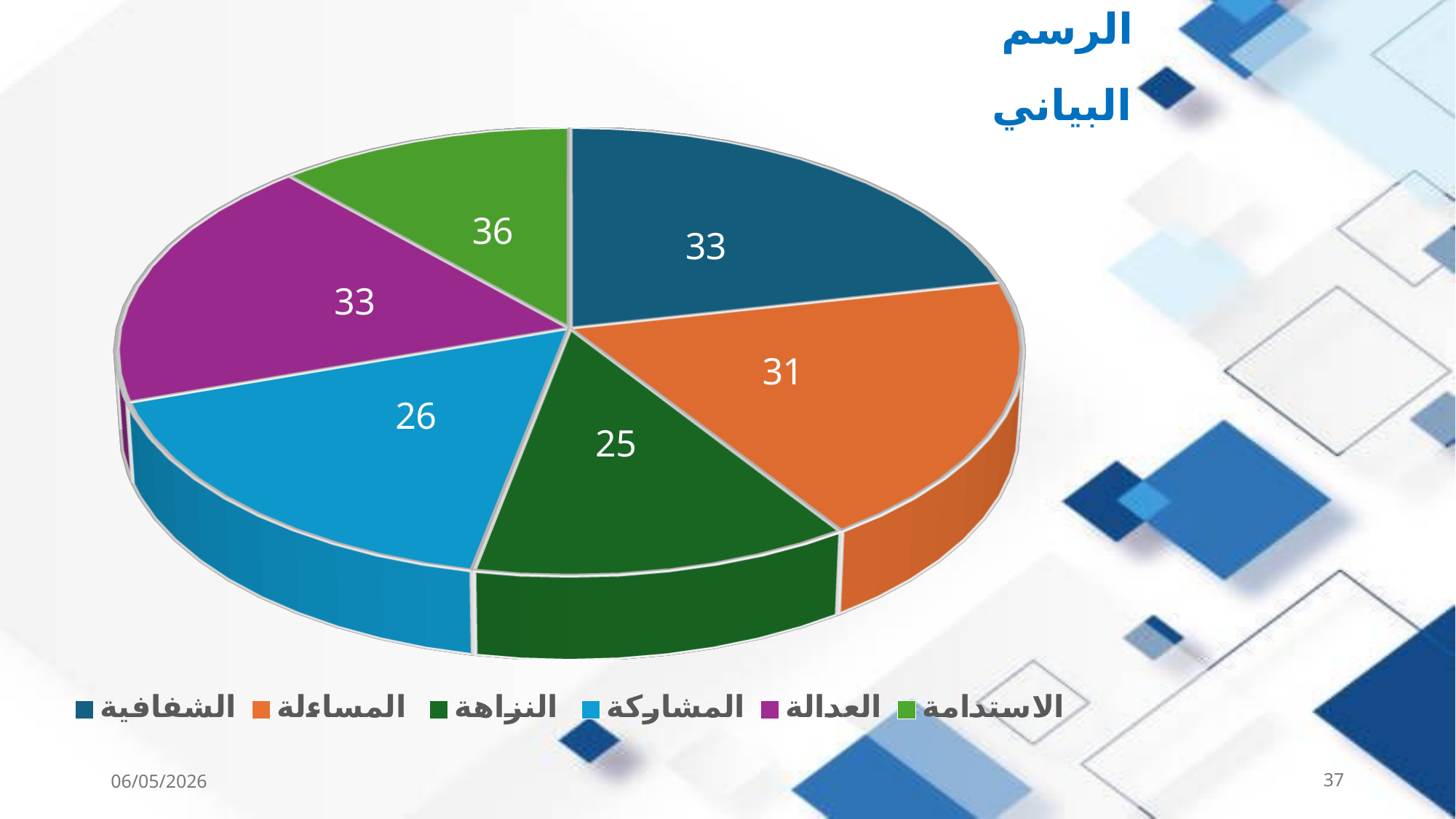
What is the value of the الاستدامة slice? 36 What is the value of the المساءلة slice? 31 Which is larger, the value for المساءلة or the value for المشاركة? المساءلة What is the value of the المشاركة slice? 26 What colour is the الشفافية slice in the pie chart? Dark teal blue What is the value of the النزاهة slice? 25 What is the total of all the slice values in the pie chart? 184 What is the difference between the values of الاستدامة and النزاهة? 11 How many slices does the pie chart have? 6 What type of chart is shown on the slide? Pie chart